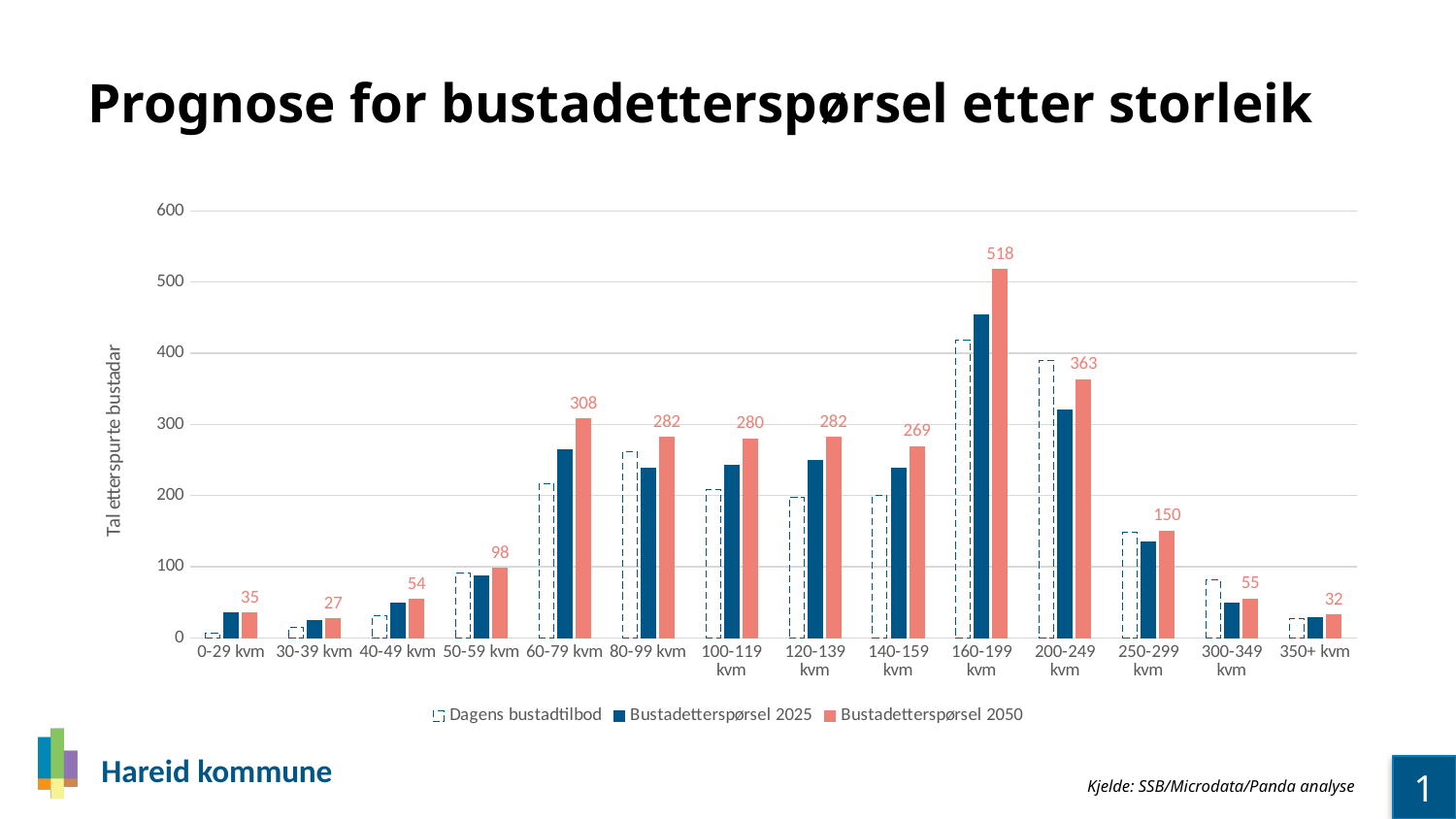
What is the Bustadetterspørsel 2050 value for 30-39 kvm? 27 How many series does the legend list? 3 Which size category has the highest Bustadetterspørsel 2050 value? 160-199 kvm Is the Bustadetterspørsel 2025 value for 160-199 kvm greater or less than 400? greater Which size category has the lowest Bustadetterspørsel 2050 value? 30-39 kvm What is the Bustadetterspørsel 2050 value for 60-79 kvm? 308 What kind of chart is shown on the slide? Bar chart What is the difference between the Bustadetterspørsel 2050 values for 160-199 kvm and 200-249 kvm? 155 Is the Dagens bustadtilbod value for 100-119 kvm greater or less than 300? less Which is larger: the Bustadetterspørsel 2050 value for 250-299 kvm or for 300-349 kvm? 250-299 kvm How many size categories are shown on the x axis? 14 What is the Bustadetterspørsel 2050 value for 160-199 kvm? 518